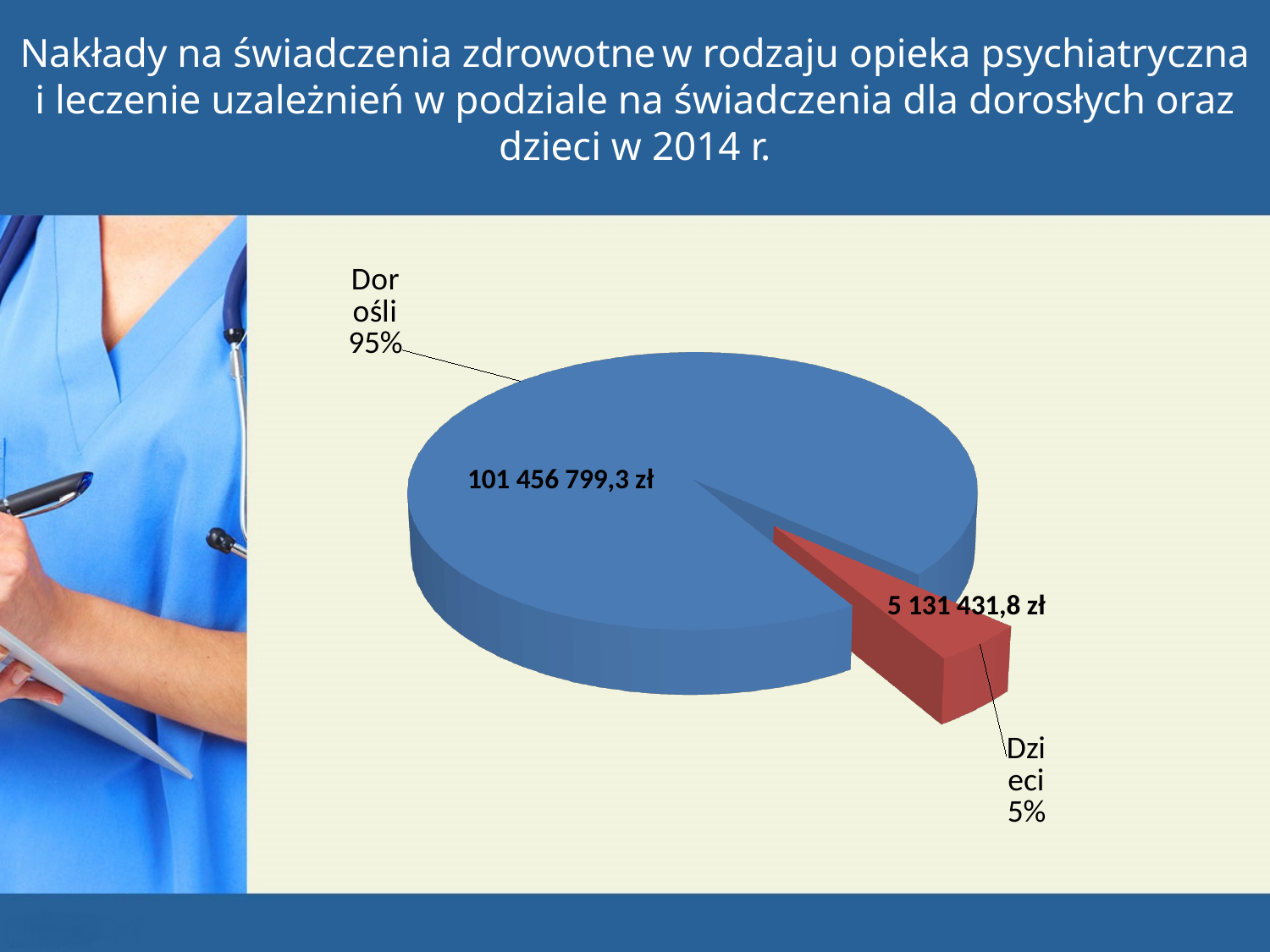
Which category has the largest slice of the pie? Dorośli What is the difference between the value for Dorośli and the value for Dzieci? 96 325 367,5 zł What share of the pie does the Dorośli slice represent? 95% Which category has the smallest slice of the pie? Dzieci What is the total of the two values shown in the pie chart? 106 588 231,1 zł What is the value shown for Dzieci? 5 131 431,8 zł What type of chart is shown on the slide? pie chart Which is larger, the value for Dorośli or the value for Dzieci? Dorośli How many slices does the pie chart have? 2 What share of the pie does the Dzieci slice represent? 5% What colour is the Dzieci slice of the pie chart? red What is the value shown for Dorośli? 101 456 799,3 zł